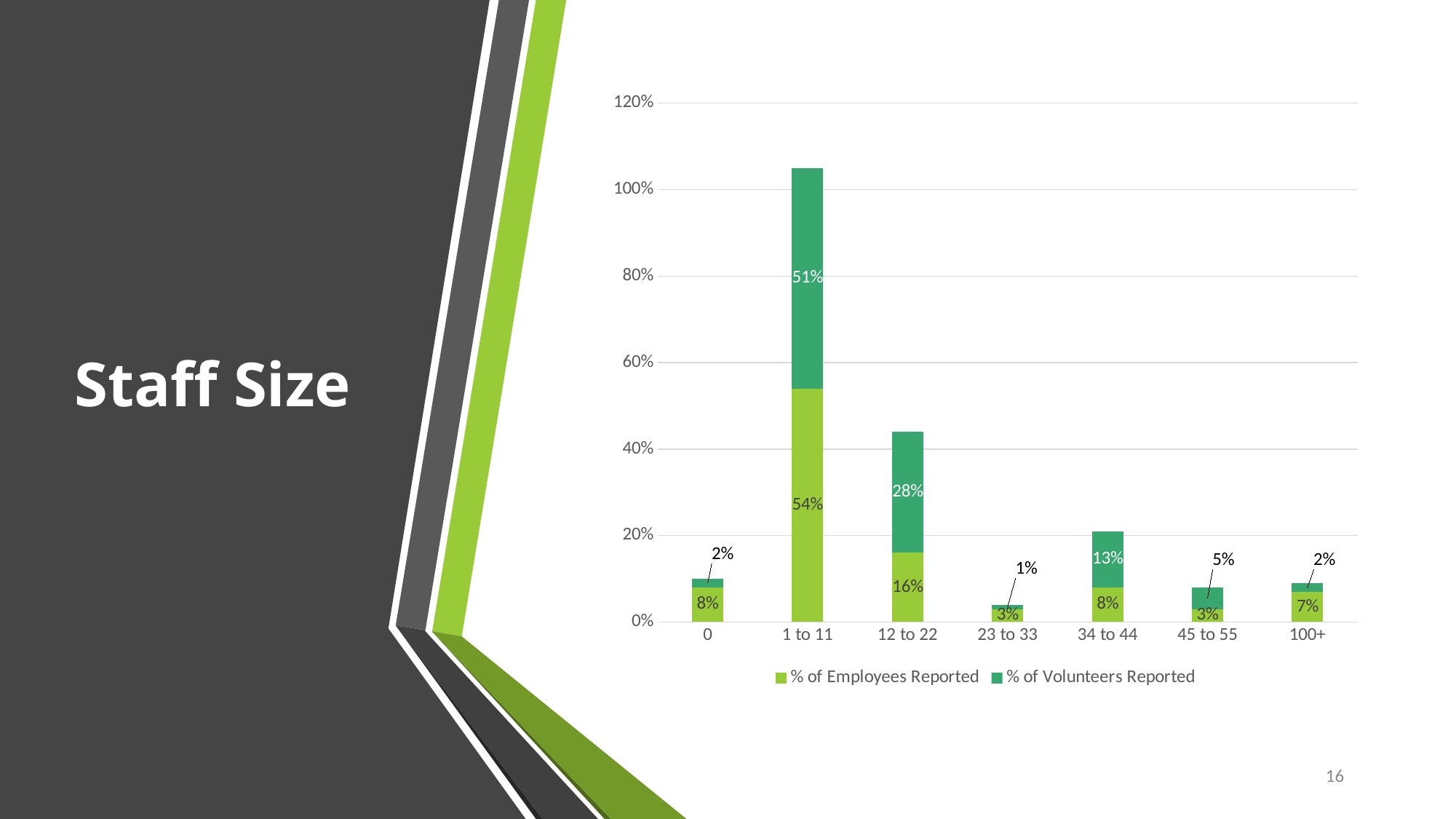
How many staff size categories are shown on the x axis? 7 Which staff size category has the highest % of Employees Reported? 1 to 11 How many series does the legend list? 2 What is the % of Volunteers Reported for the 12 to 22 category? 28% For the 34 to 44 category, which is larger: % of Employees Reported or % of Volunteers Reported? % of Volunteers Reported What is the % of Employees Reported for the 100+ category? 7% What is the total height of the stacked bar for the 1 to 11 category? 105% Which staff size category has the lowest % of Volunteers Reported? 23 to 33 What is the difference between the % of Employees Reported and the % of Volunteers Reported for the 12 to 22 category? 12% What kind of chart is shown on the slide? Stacked bar chart What is the % of Volunteers Reported for the 34 to 44 category? 13% What is the % of Employees Reported for the 1 to 11 staff size category? 54%